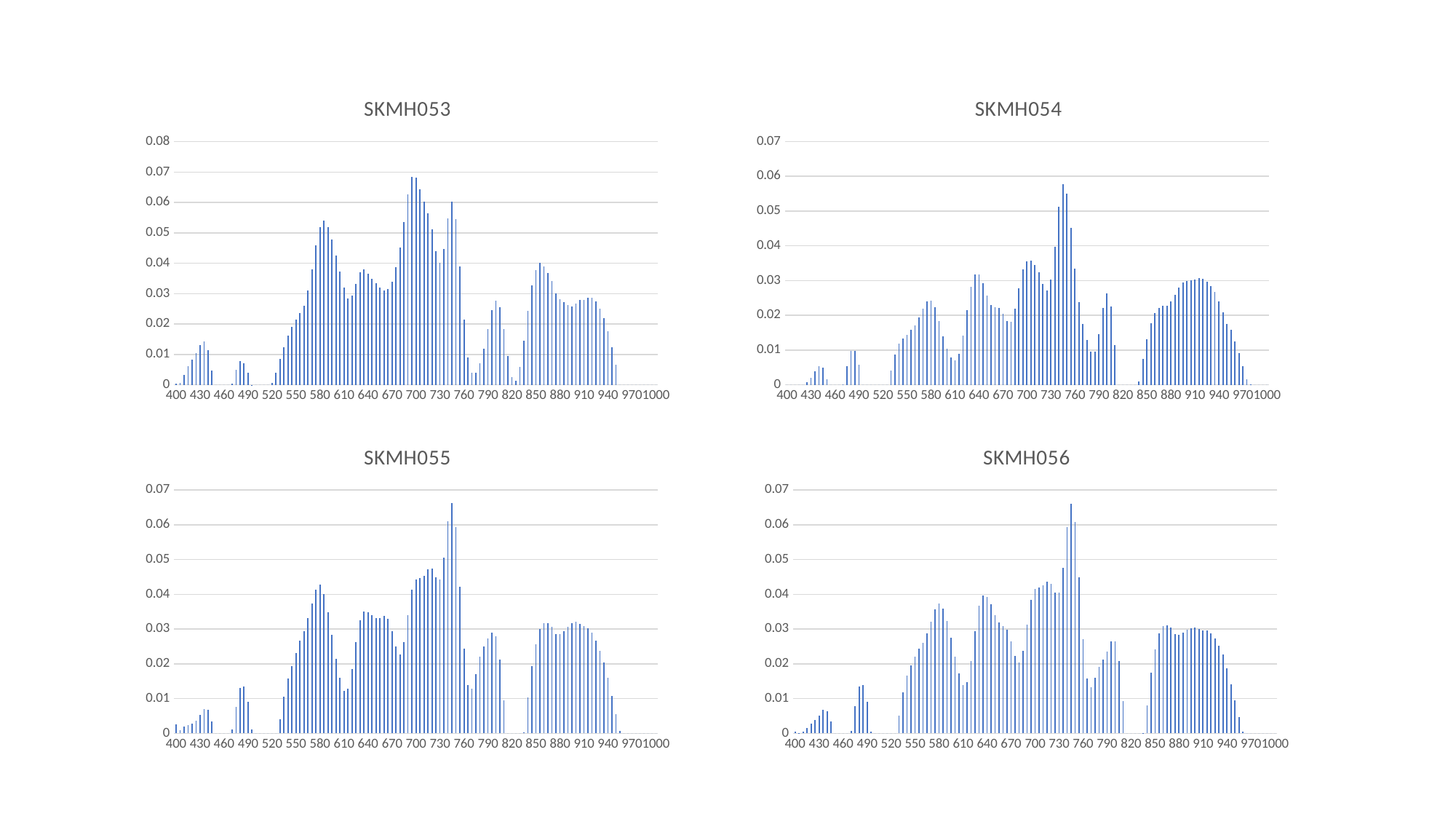
In the SKMH056 chart, is the value at 640 greater or less than 0.03? greater In the SKMH053 chart, is the tallest bar near 700 greater or less than 0.06? greater What kind of chart is SKMH053? bar chart In the SKMH054 chart, is the value at 700 greater or less than 0.03? greater How many charts are shown on the slide? 4 What is the highest value shown on the vertical axis of the SKMH053 chart? 0.08